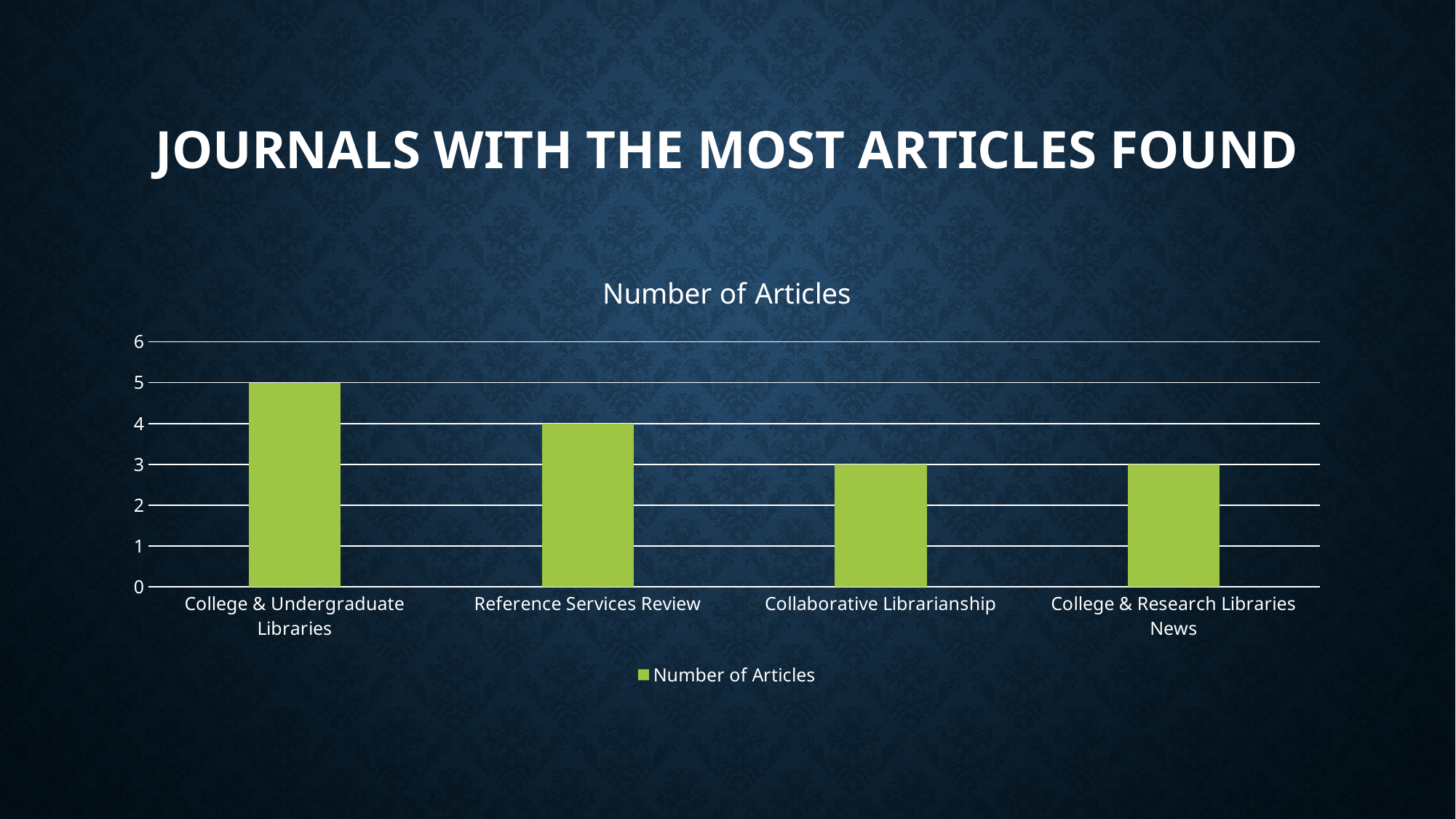
What is the value for College & Undergraduate Libraries? 5 What is the difference between the values for Reference Services Review and Collaborative Librarianship? 1 Which journal has the highest number of articles? College & Undergraduate Libraries What is the difference between the values for College & Undergraduate Libraries and Reference Services Review? 1 What is the value for Collaborative Librarianship? 3 How many series does the legend list? 1 What is the value for Reference Services Review? 4 What is the title of the chart? Number of Articles How many journals are shown on the chart? 4 Which is larger, the value for College & Undergraduate Libraries or the value for Collaborative Librarianship? College & Undergraduate Libraries What is the value for College & Research Libraries News? 3 What kind of chart is shown on the slide? bar chart